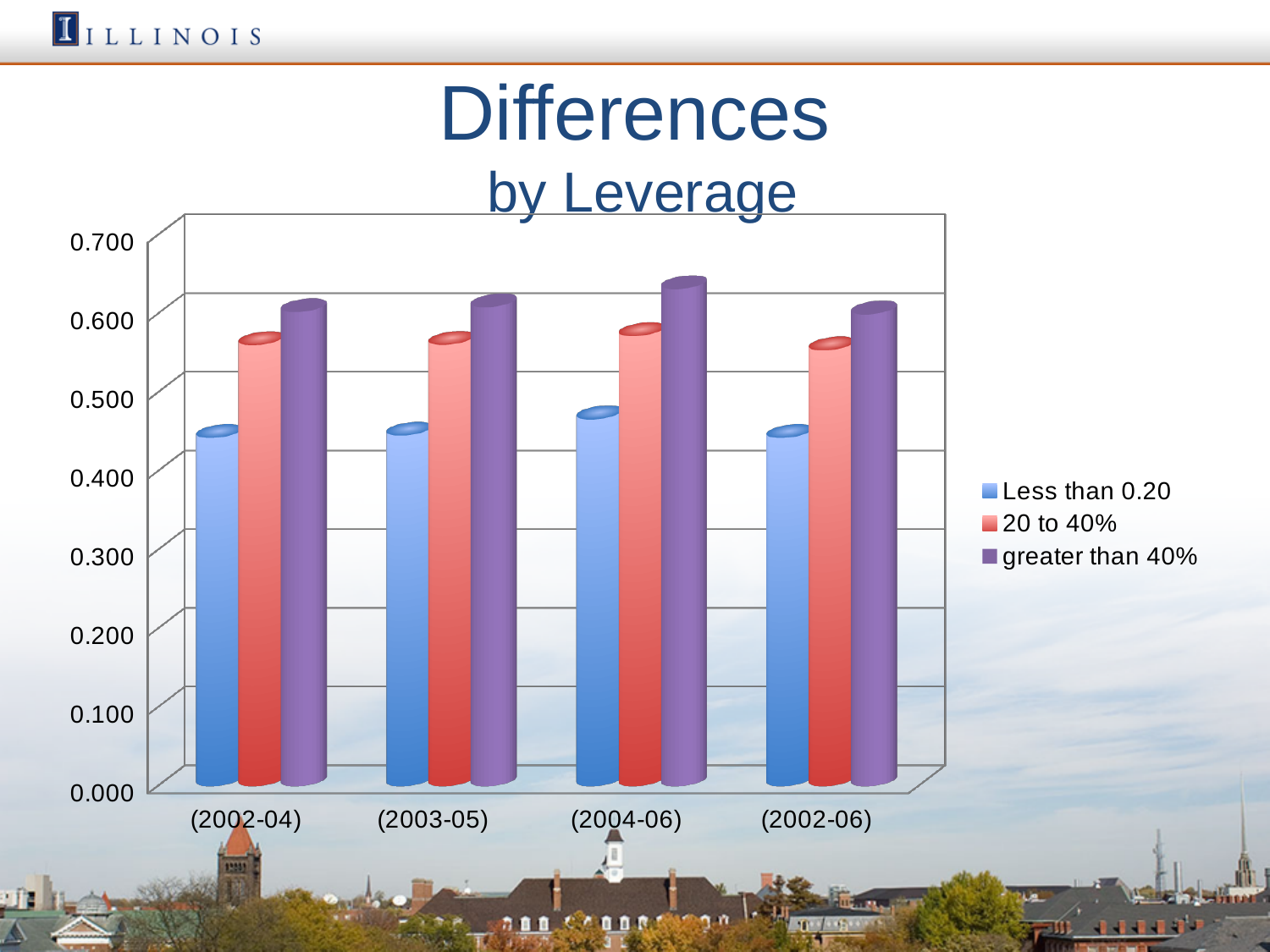
Which series has the highest value in the (2002-04) category? greater than 40% Which series has the lowest value in the (2004-06) category? Less than 0.20 In the (2002-06) category, which is larger: the value for 20 to 40% or the value for Less than 0.20? 20 to 40% Is the value for greater than 40% in (2004-06) greater or less than 0.600? greater How many series does the legend list? 3 What kind of chart is shown on the slide? bar chart Is the value for 20 to 40% in (2004-06) greater or less than 0.600? less How many categories are shown on the x axis? 4 Is the value for 20 to 40% in (2002-06) greater or less than 0.500? greater What is the title of the chart on the slide? Differences by Leverage For the greater than 40% series, which category has the highest value? (2004-06)